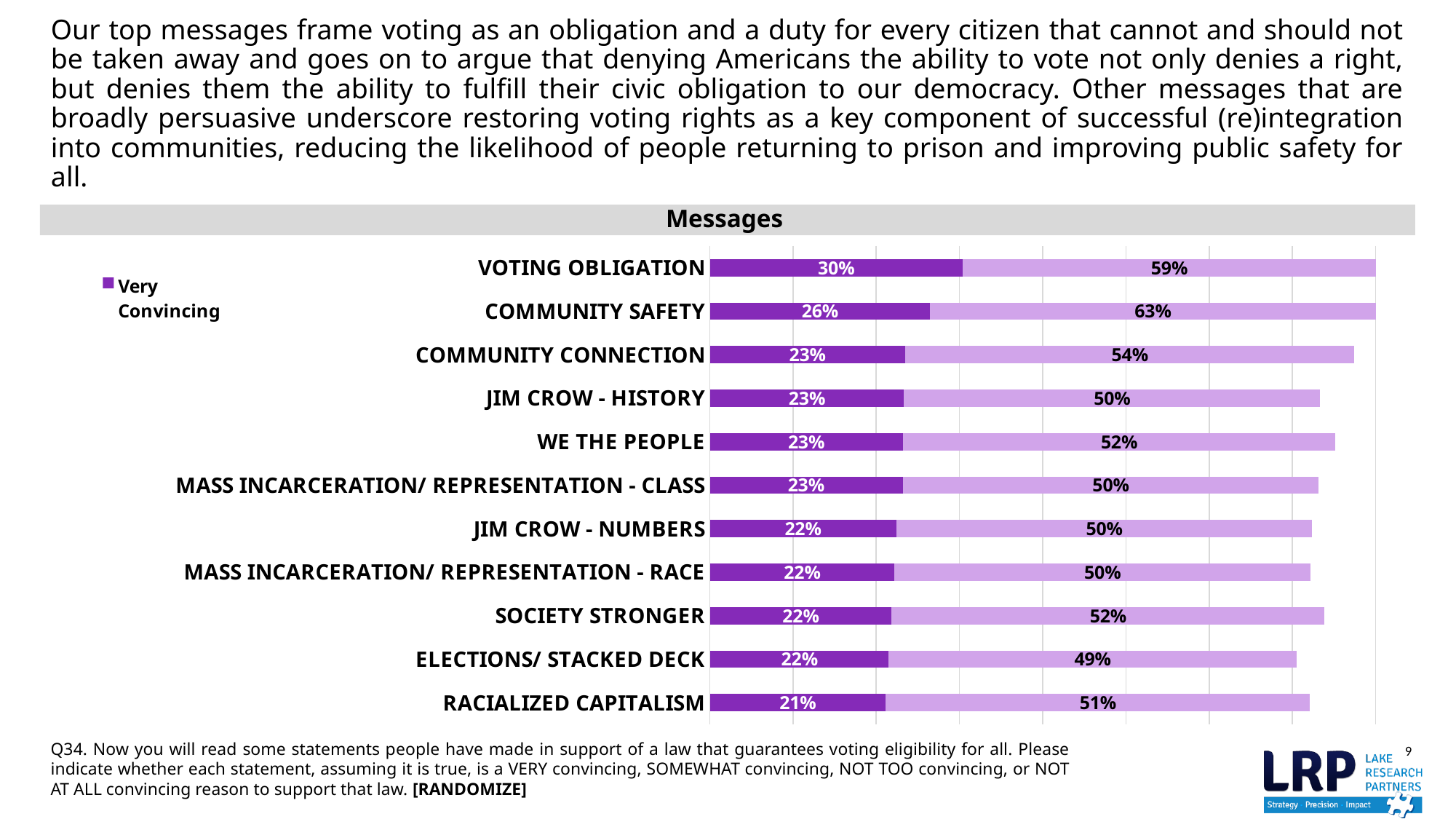
What kind of chart is shown on the slide? bar chart Which message has the highest value on its lighter purple segment? COMMUNITY SAFETY What is the 'Very Convincing' value for COMMUNITY SAFETY? 26% What is the difference between the 'Very Convincing' values for VOTING OBLIGATION and COMMUNITY SAFETY? 4 percentage points What value is printed on the lighter purple segment for COMMUNITY SAFETY? 63% Which has the larger lighter purple segment value, COMMUNITY CONNECTION or JIM CROW - HISTORY? COMMUNITY CONNECTION How many message categories are plotted in the chart? 11 Which message has the lowest value on its lighter purple segment? ELECTIONS/ STACKED DECK Which message has the highest 'Very Convincing' value? VOTING OBLIGATION Which message has the lowest 'Very Convincing' value? RACIALIZED CAPITALISM What is the 'Very Convincing' value for VOTING OBLIGATION? 30% What is the title of the chart? Messages